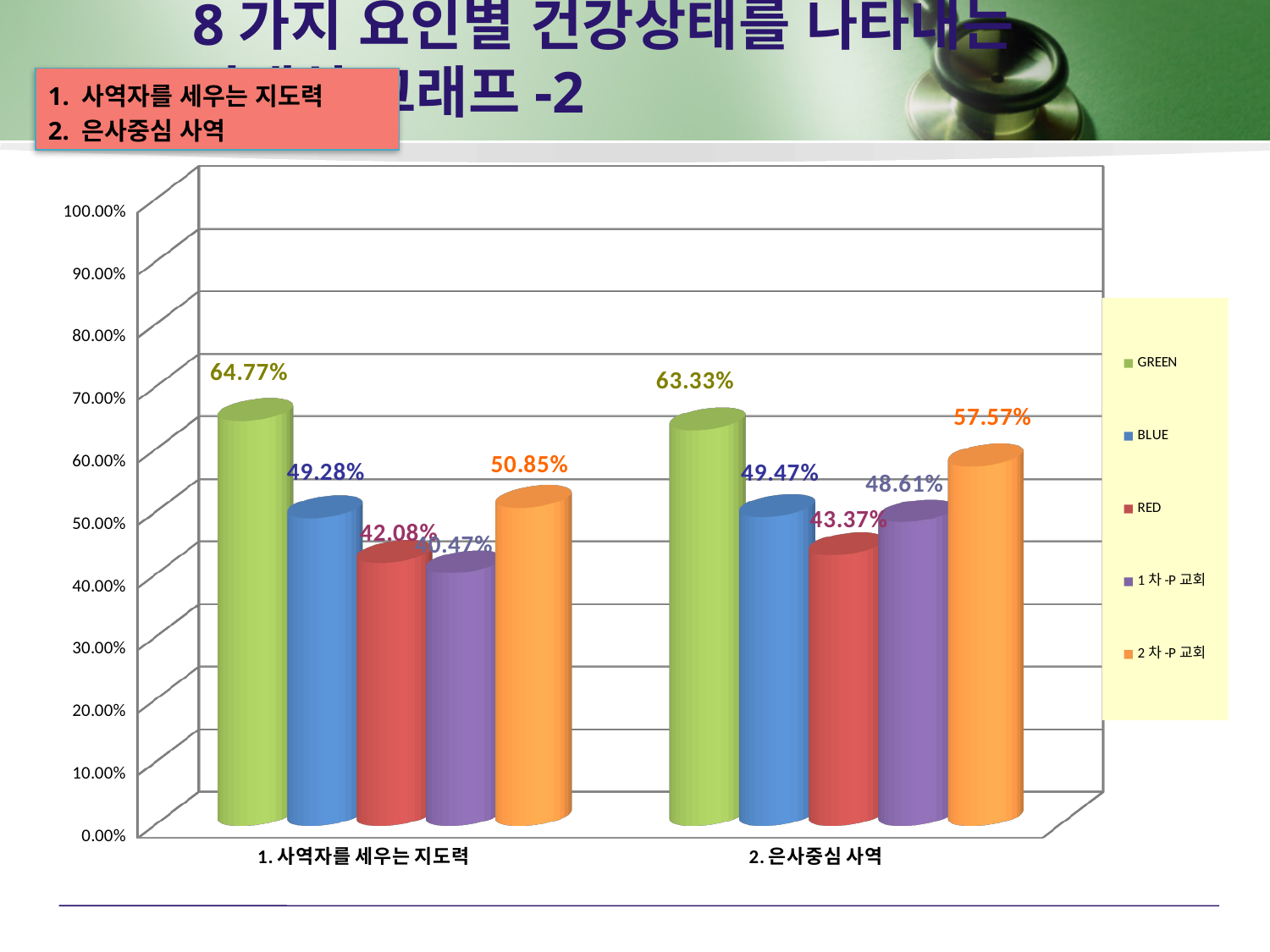
For the 2 차 -P 교회 series, which category has the larger value: 1. 사역자를 세우는 지도력 or 2. 은사중심 사역? 2. 은사중심 사역 In the category 2. 은사중심 사역, how much larger is the 2 차 -P 교회 value than the RED value? 14.20% What is the value of the GREEN series for the category 1. 사역자를 세우는 지도력? 64.77% What kind of chart is shown on the slide? bar chart What is the difference between the GREEN values for 1. 사역자를 세우는 지도력 and 2. 은사중심 사역? 1.44% What is the value of the RED series for the category 1. 사역자를 세우는 지도력? 42.08% How many series does the legend list? 5 What is the value of the 2 차 -P 교회 series for the category 2. 은사중심 사역? 57.57% Which series has the lowest value in the category 2. 은사중심 사역? RED What is the value of the 1 차 -P 교회 series for the category 2. 은사중심 사역? 48.61% Is the RED value for 1. 사역자를 세우는 지도력 greater or less than 50.00%? less Which series has the highest value in the category 2. 은사중심 사역? GREEN